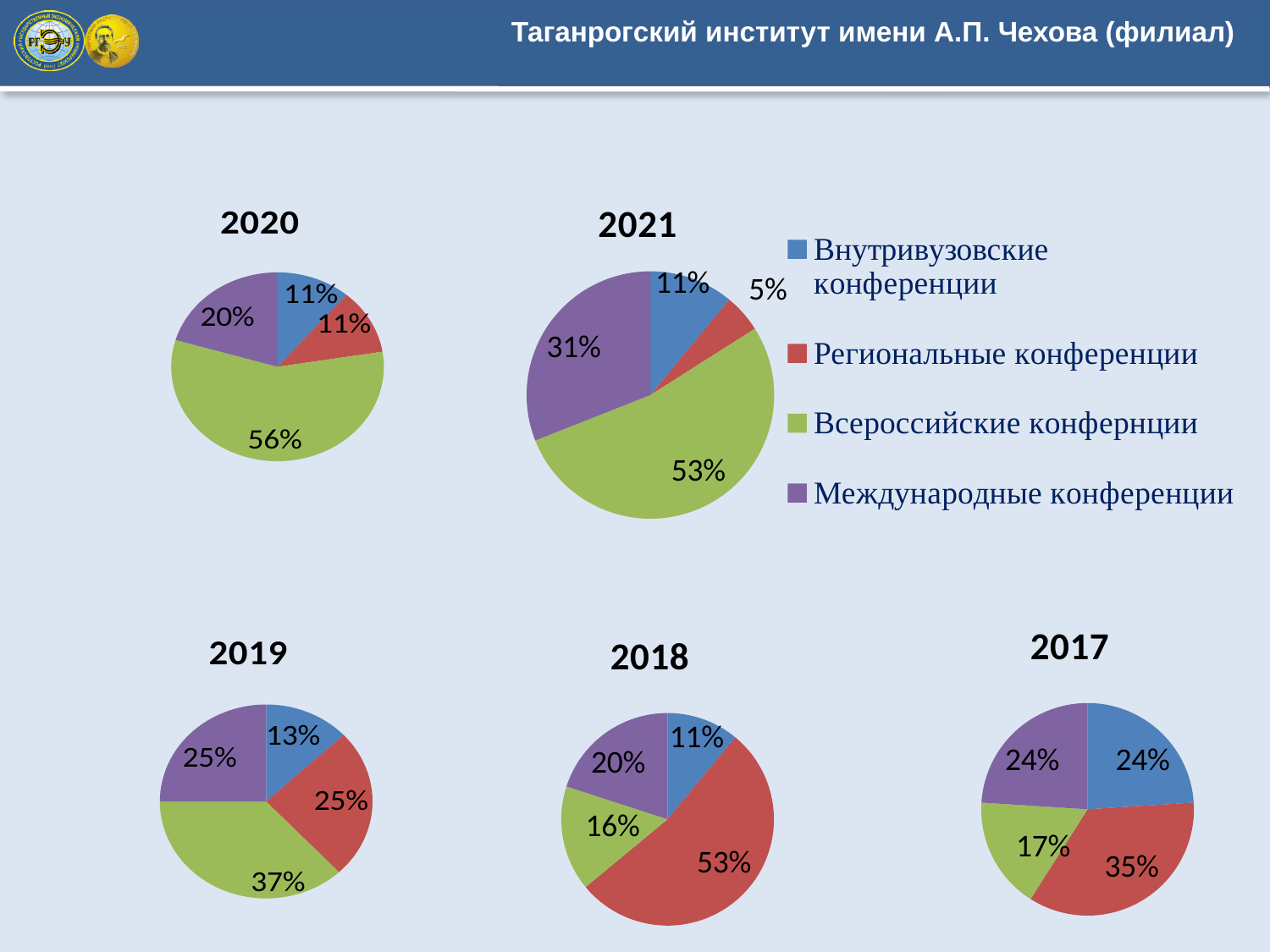
What type of chart is used for the 2020 data? Pie chart In the 2017 pie chart, which is larger: the share of Региональные конференции or the share of Внутривузовские конференции? Региональные конференции How many pie charts are shown on the slide? 5 In the 2020 pie chart, what share do Всероссийские конфернции have? 56% In the 2019 pie chart, which category has the largest share? Всероссийские конфернции In the 2021 pie chart, which category has the smallest share? Региональные конференции In the 2018 pie chart, what share do Региональные конференции have? 53% In the 2018 pie chart, which category has the largest share? Региональные конференции How many categories does the legend list? 4 In the 2017 pie chart, what share do Всероссийские конфернции have? 17% In the 2021 pie chart, what is the difference between the shares of Всероссийские конфернции and Международные конференции? 22% In the 2021 pie chart, what share do Региональные конференции have? 5%